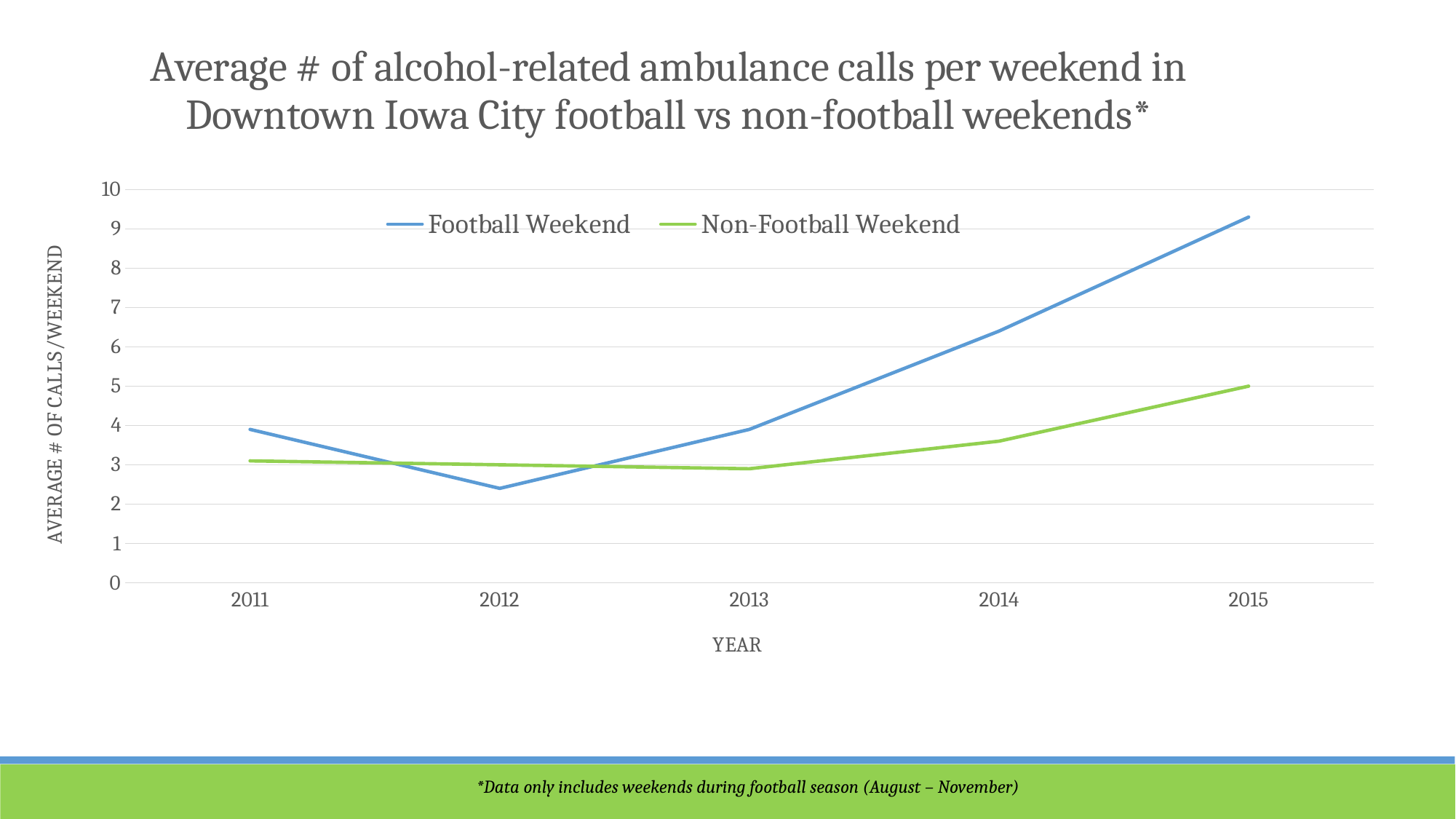
Which year has the highest value for Non-Football Weekend? 2015 Does the Football Weekend line rise or fall from 2013 to 2015? rise Is the value for Football Weekend in 2012 greater or less than 3? less Is the value for Football Weekend in 2015 greater or less than 9? greater What kind of chart is shown on the slide? line chart How many series does the legend list? 2 What is the label of the y axis? AVERAGE # OF CALLS/WEEKEND Which year has the lowest value for Football Weekend? 2012 Is the value for Non-Football Weekend in 2014 greater or less than 4? less Which year has the highest value for Football Weekend? 2015 In 2014, which series has the larger value, Football Weekend or Non-Football Weekend? Football Weekend How many years are plotted along the x axis? 5